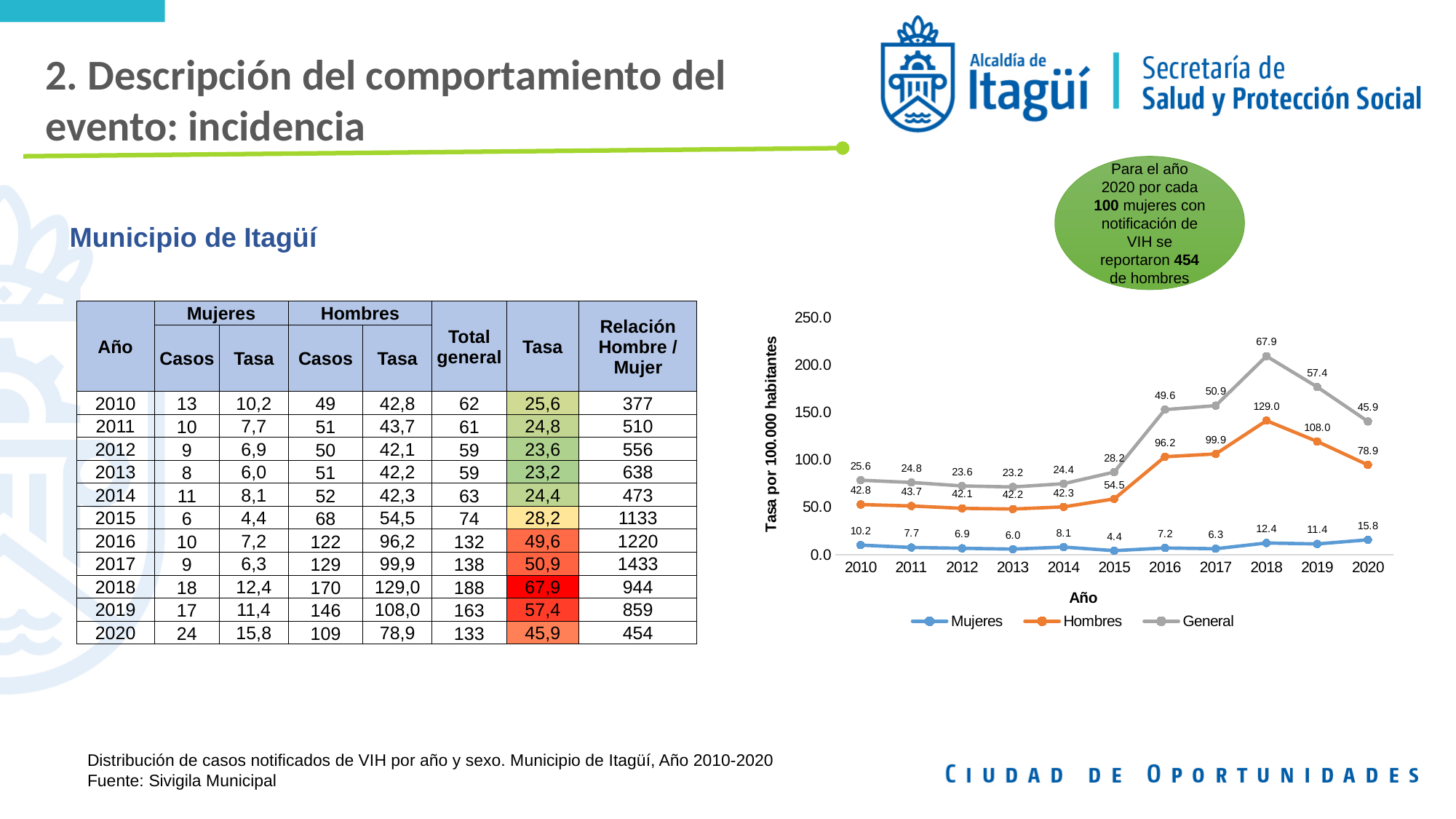
In which year does the Hombres series reach its highest labelled value? 2018 How many years are shown on the x axis of the chart? 11 What is the value labelled for Hombres in 2018? 129.0 Does the Hombres series rise or fall between 2015 and 2018? rise What type of chart is shown on the slide? line chart Which series has the larger labelled value in 2017, Hombres or Mujeres? Hombres What is the value labelled for Mujeres in 2020? 15.8 What is the value labelled for General in 2016? 49.6 What is the difference between the Hombres values labelled for 2018 and 2019? 21.0 How many series does the chart legend list? 3 In which year does the Mujeres series have its lowest labelled value? 2015 What is the label of the chart's y axis? Tasa por 100.000 habitantes